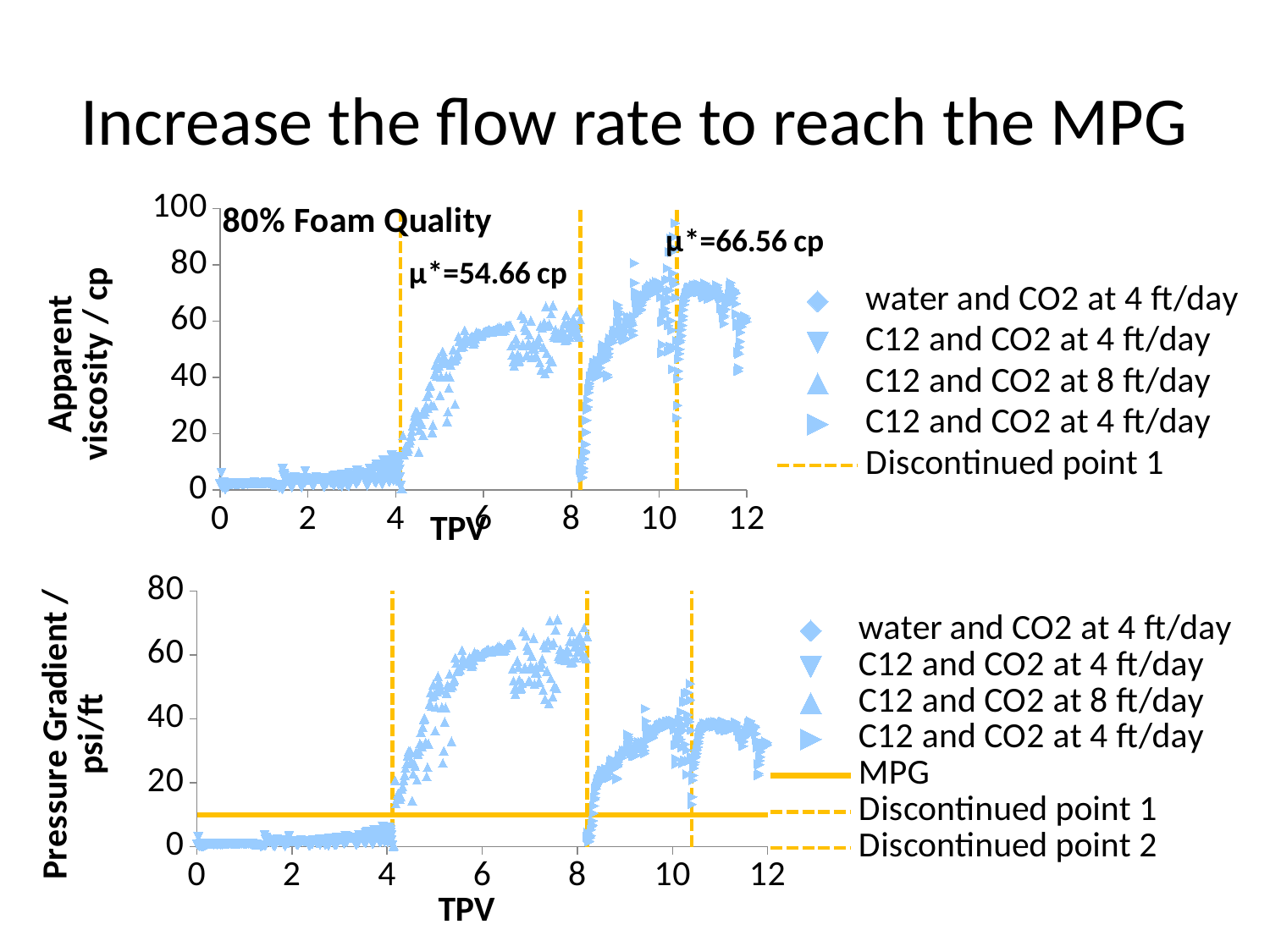
What is the y-axis title of the bottom chart? Pressure Gradient / psi/ft What foam quality is stated on the top chart? 80% Foam Quality In the bottom chart, is the MPG line greater or less than 20 psi/ft? less In the top chart, is the apparent viscosity at TPV 11 greater or less than 60? greater In the bottom chart, is the pressure gradient at TPV 6 greater or less than 40? greater What kind of chart is the top chart on the slide? scatter chart In the top chart, does the apparent viscosity rise or fall between TPV 4 and TPV 6? rise In the top chart, what is the μ* value annotated between the first and second dashed lines? μ*=54.66 cp How many entries does the legend of the top chart (Apparent viscosity) list? 5 In the top chart, what is the μ* value annotated near the third dashed line? μ*=66.56 cp How many entries does the legend of the bottom chart (Pressure Gradient) list? 7